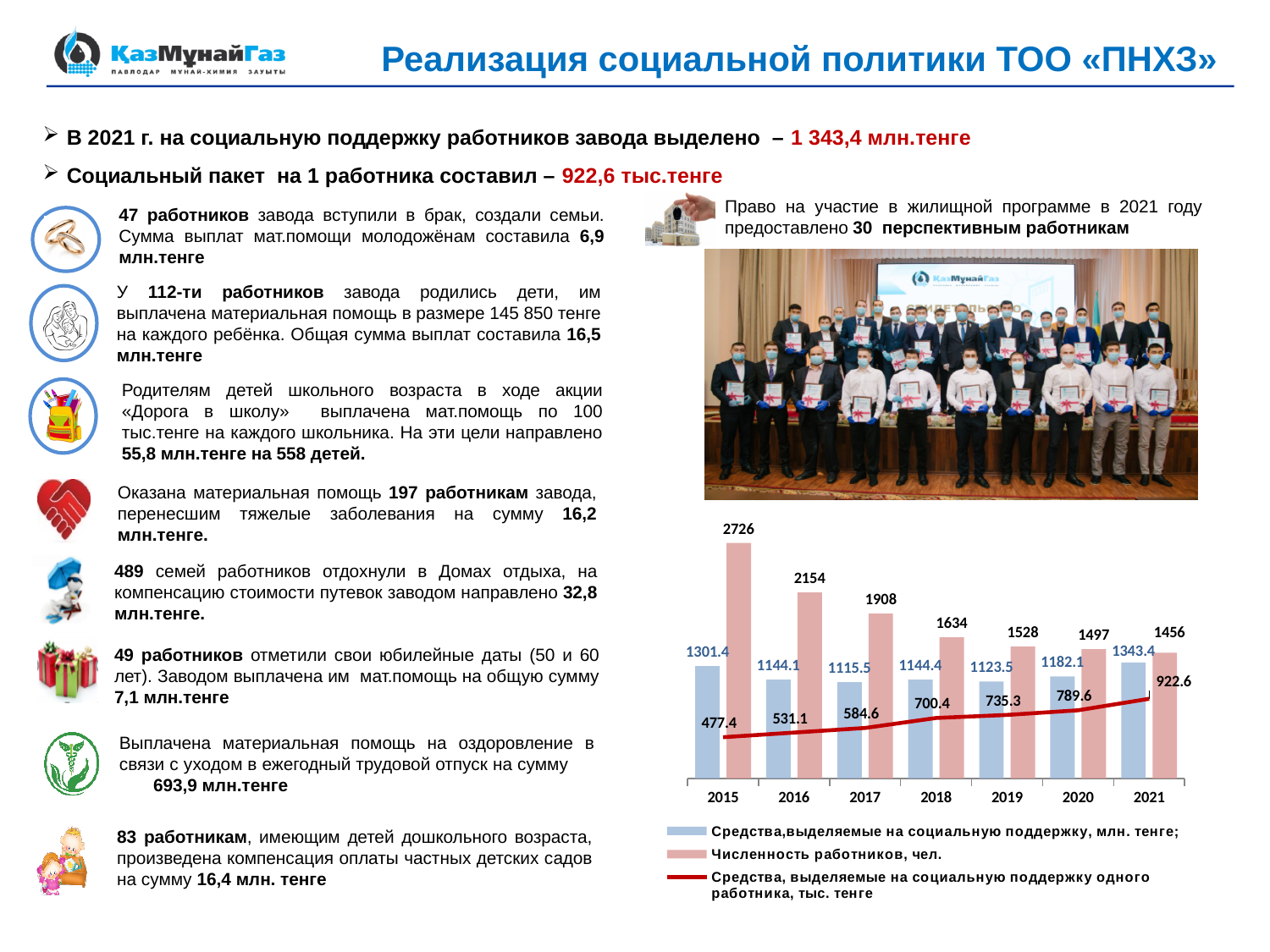
In which year is the value of the red line (funds per worker) lowest? 2015 How many years are shown on the x axis of the chart? 7 What is the headcount (Численность работников, чел.) shown for 2015? 2726 What is the value of the red line (Средства на социальную поддержку одного работника, тыс. тенге) for 2018? 700.4 In which year is the headcount (Численность работников) highest? 2015 Does the headcount (Численность работников) rise or fall from 2015 to 2021? fall How many series does the chart legend list? 3 What is the value of the blue series (Средства, выделяемые на социальную поддержку, млн. тенге) for 2021? 1343.4 Which series in the chart is drawn as a red line? Средства, выделяемые на социальную поддержку одного работника, тыс. тенге Which is larger: the social support funds (blue bar) in 2015 or in 2021? 2021 What is the difference between the headcount in 2015 and in 2021? 1270 In which year is the blue series (social support funds, mln tenge) lowest? 2017